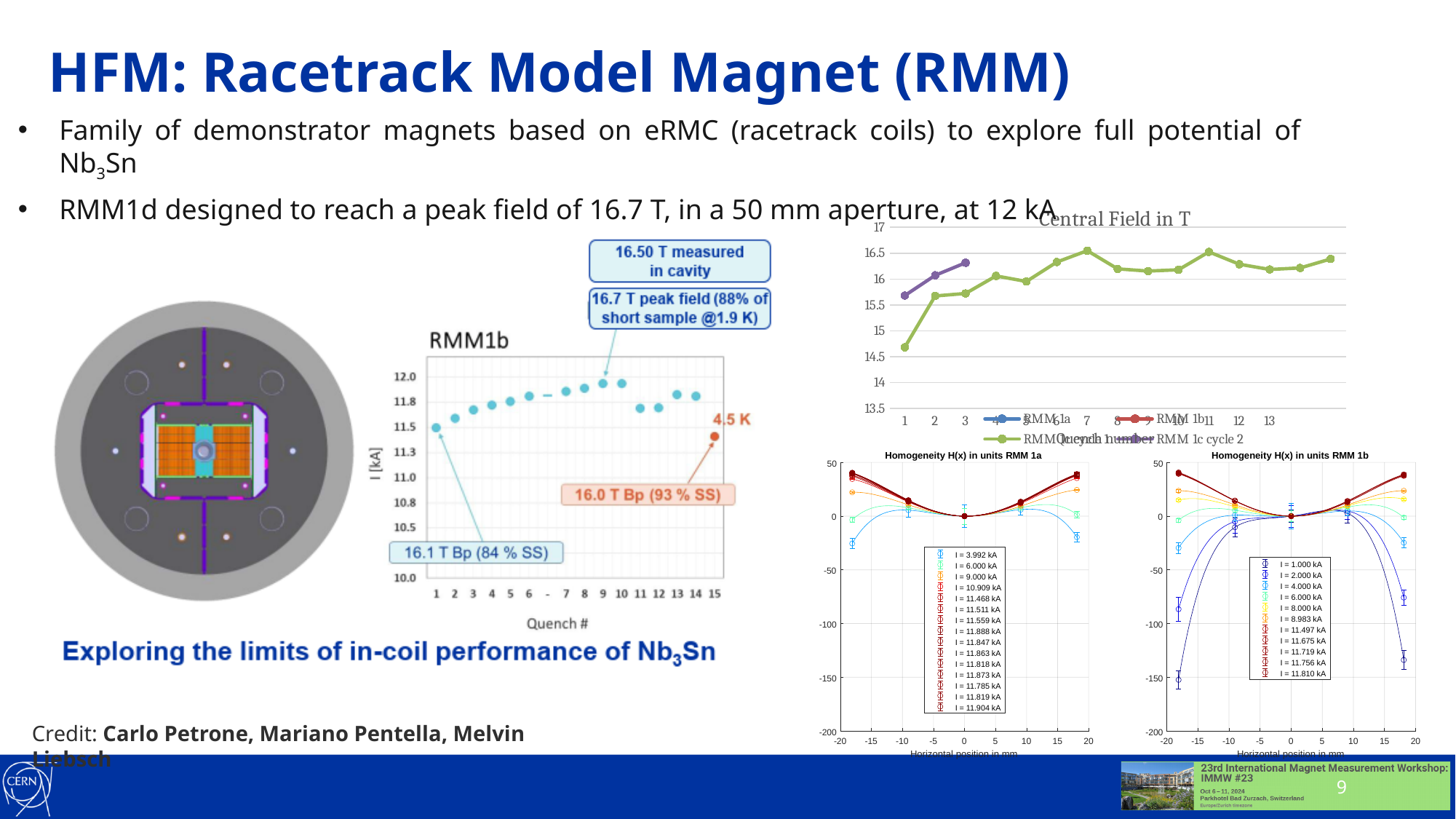
In the 'Central Field in T' chart, do the values generally rise or fall as the quench number increases? rise How many series does the legend of the 'Central Field in T' chart list? 4 How many current values are listed in the legend of the 'Homogeneity H(x) in units RMM 1b' chart? 11 In the RMM1b chart, is the current at quench 1 greater or less than 11.8 kA? less What is the x-axis title of the RMM1b chart? Quench # In the 'Central Field in T' chart, is the value at quench number 7 greater or less than 16? greater In the RMM1b chart, what percentage of short sample does the 16.0 T Bp point at 4.5 K correspond to? 93 % SS In the RMM1b chart, what field was measured in the cavity according to the annotation? 16.50 T In the RMM1b chart, is the current at quench 9 greater or less than 11.8 kA? greater What kind of chart is the 'Central Field in T' chart? line chart